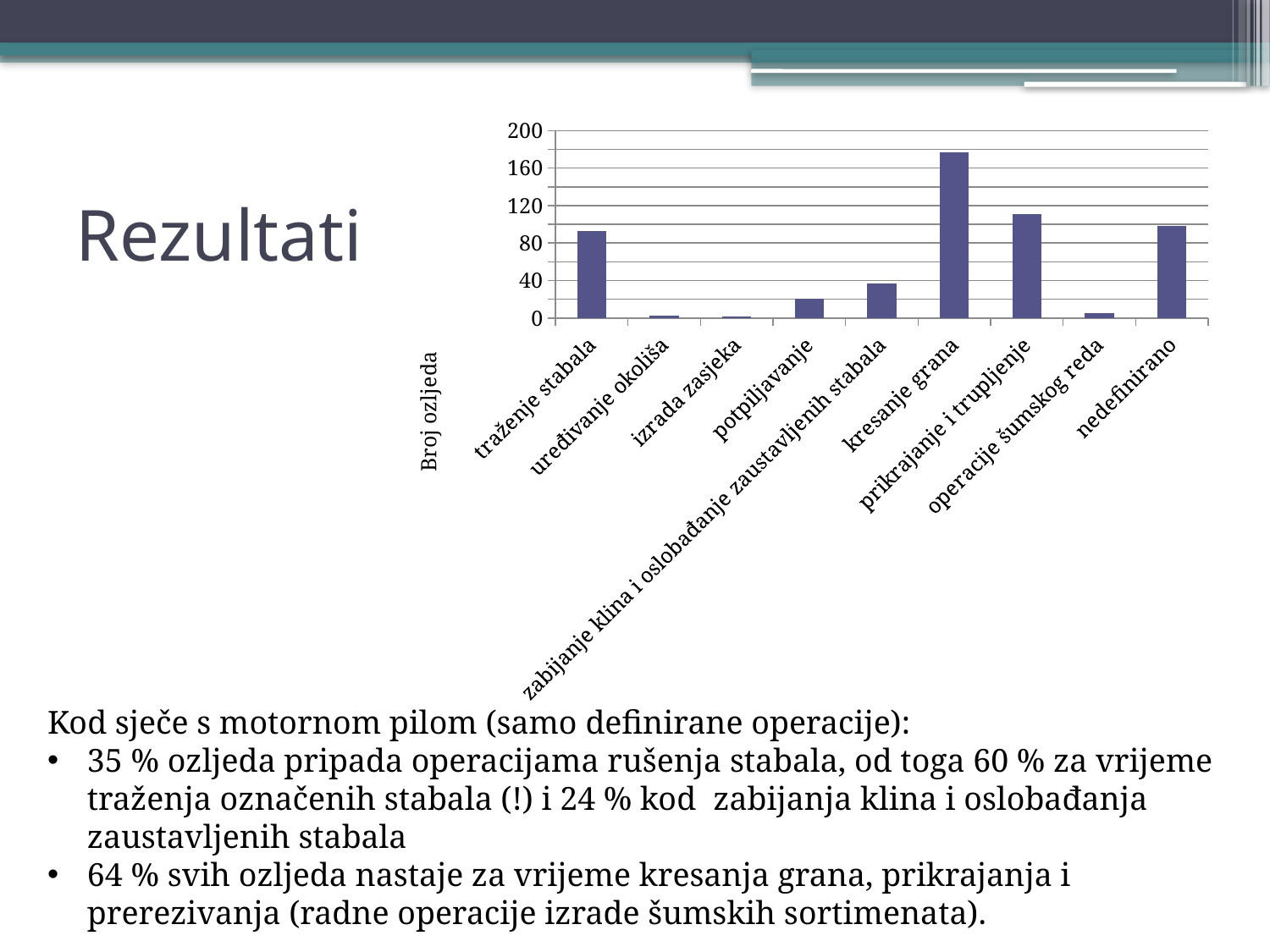
What is the label of the vertical axis of the chart? Broj ozljeda Is the value for nedefinirano greater or less than 80? greater What kind of chart is shown on the slide? bar chart Which is larger, the value for prikrajanje i trupljenje or the value for traženje stabala? prikrajanje i trupljenje Is the value for kresanje grana greater or less than 160? greater Which is larger, the value for potpiljavanje or the value for operacije šumskog reda? potpiljavanje Is the value for potpiljavanje greater or less than 40? less How many categories are shown on the x axis of the chart? 9 Which category has the highest number of injuries (Broj ozljeda)? kresanje grana